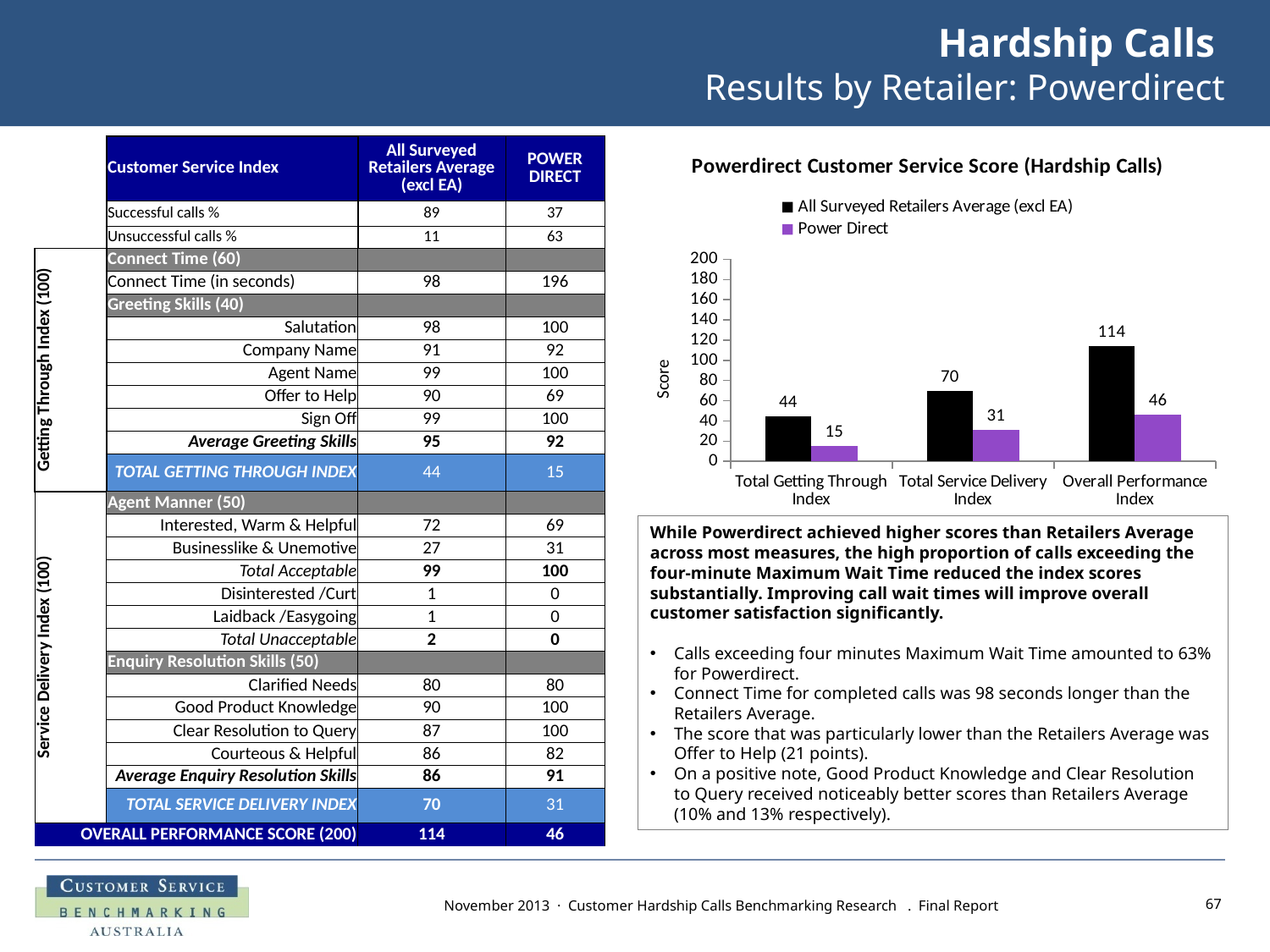
What is the difference between the All Surveyed Retailers Average (excl EA) and Power Direct values for Overall Performance Index? 68 How many series does the chart legend list? 2 Which is larger for Total Service Delivery Index: the All Surveyed Retailers Average (excl EA) or Power Direct? All Surveyed Retailers Average (excl EA) What is the Power Direct value for Total Service Delivery Index? 31 What is the title of the chart? Powerdirect Customer Service Score (Hardship Calls) What is the Power Direct value for Overall Performance Index? 46 Which category has the highest All Surveyed Retailers Average (excl EA) value? Overall Performance Index How many categories are shown on the x axis of the chart? 3 Is the All Surveyed Retailers Average (excl EA) value for Overall Performance Index greater or less than 100? greater Which category has the lowest Power Direct value? Total Getting Through Index What kind of chart is shown on the slide? Bar chart What is the All Surveyed Retailers Average (excl EA) value for Total Getting Through Index? 44